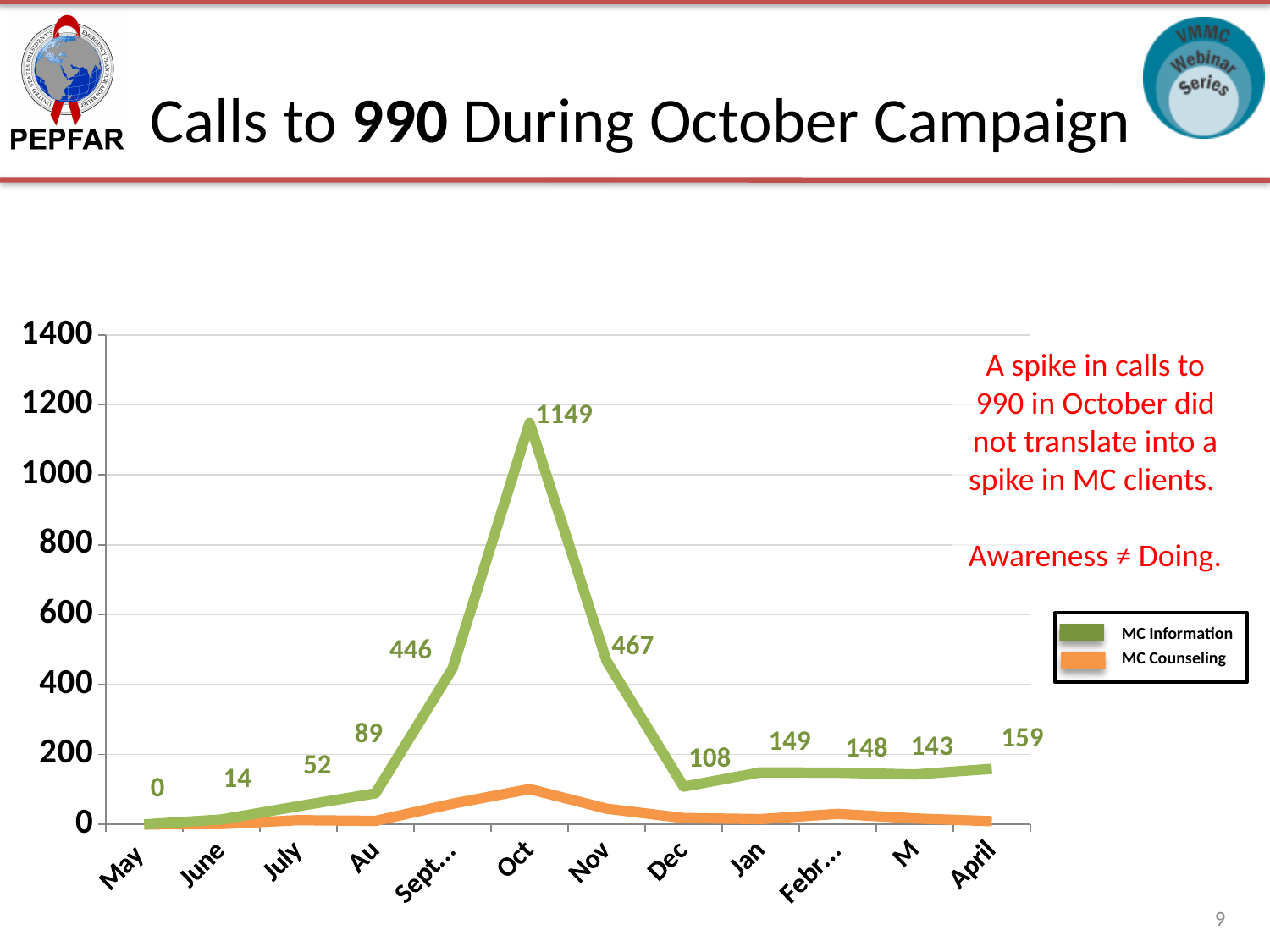
How many months are shown on the x axis? 12 What is the difference between the MC Information values for Oct and Nov? 682 Which is larger for MC Information, Jan or Dec? Jan Does MC Information rise or fall from May to Oct? rise What kind of chart is shown on the slide? line chart What is the value of MC Information in Nov? 467 Is the value for MC Counseling in Oct greater or less than 200? less In which month is MC Information highest? Oct In which month is MC Information lowest? May What is the value of MC Information in Oct? 1149 How many series does the legend list? 2 What is the value of MC Information in April? 159